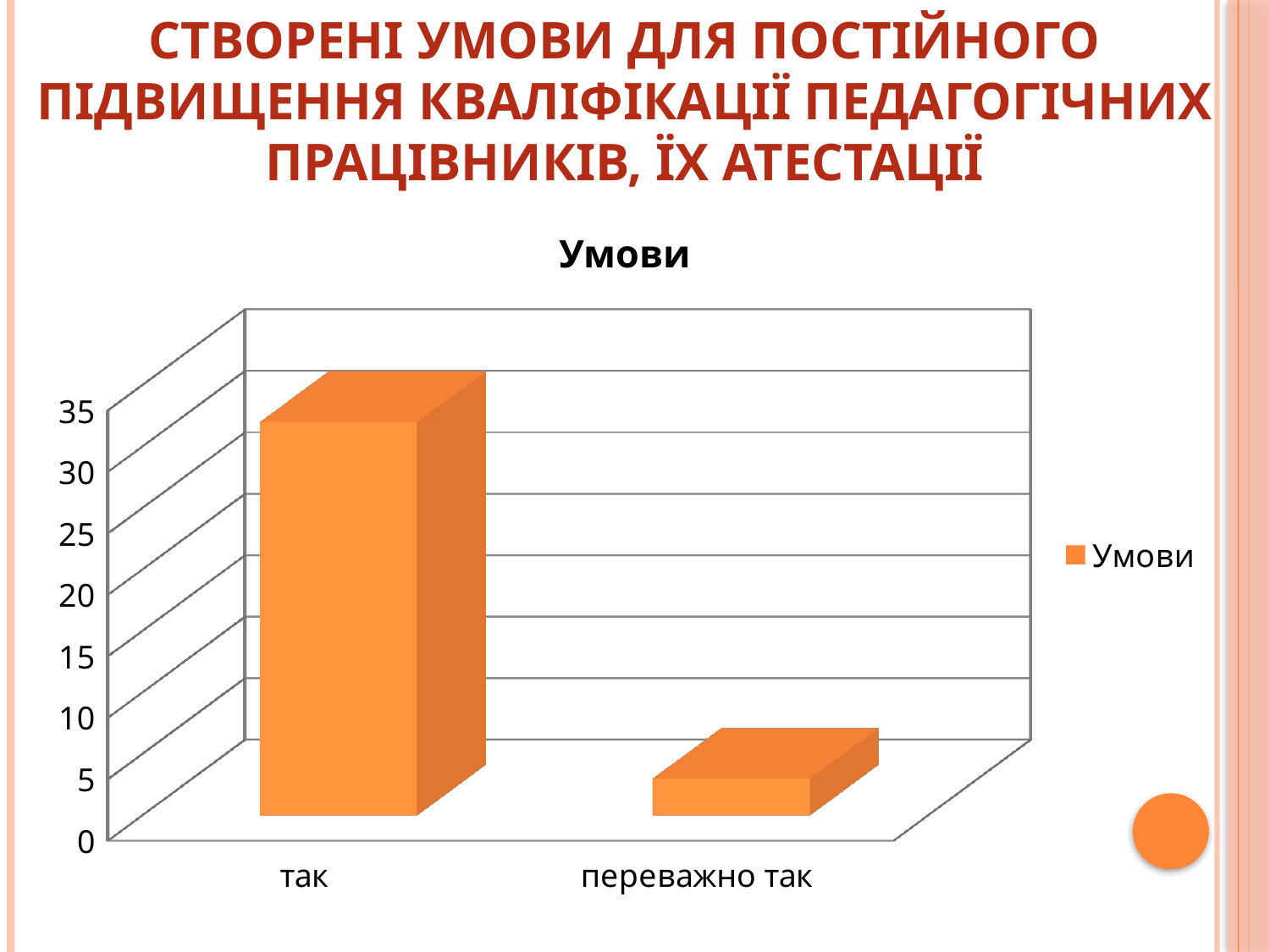
How many series does the chart legend list? 1 How many categories are shown on the x axis of the chart? 2 Is the value for "так" greater or less than 30? greater Which is larger, the value for "так" or the value for "переважно так"? так Do the values rise or fall from "так" to "переважно так" along the x axis? fall What kind of chart is shown on the slide? bar chart What is the title of the chart? Умови What is the name of the series shown in the chart legend? Умови Is the value for "переважно так" greater or less than 10? less Which category has the highest value in the chart? так Which category has the lowest value in the chart? переважно так Is the value for "так" greater or less than 20? greater